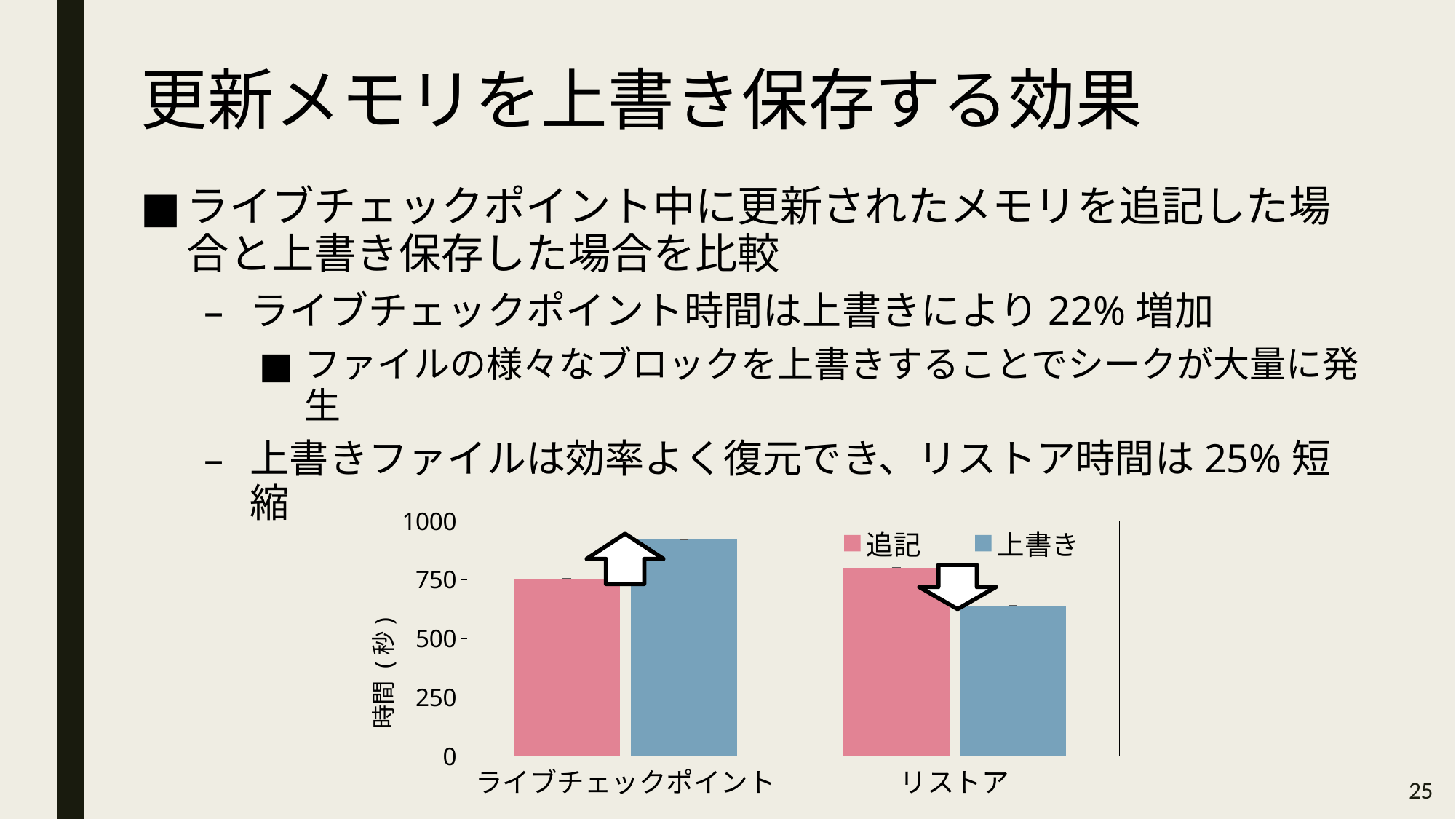
What are the two series named in the chart legend? 追記 and 上書き Is the 上書き value for ライブチェックポイント greater or less than 750? greater Is the 上書き value for リストア greater or less than 750? less What is the label of the y axis of the chart? 時間（秒） How many categories are shown on the x axis of the chart? 2 Which bar in the chart is the tallest? 上書き for ライブチェックポイント What kind of chart is shown on the slide? bar chart For ライブチェックポイント, which series has the larger value, 追記 or 上書き? 上書き Is the 追記 value for リストア greater or less than 750? greater How many series does the chart legend list? 2 For リストア, which series has the larger value, 追記 or 上書き? 追記